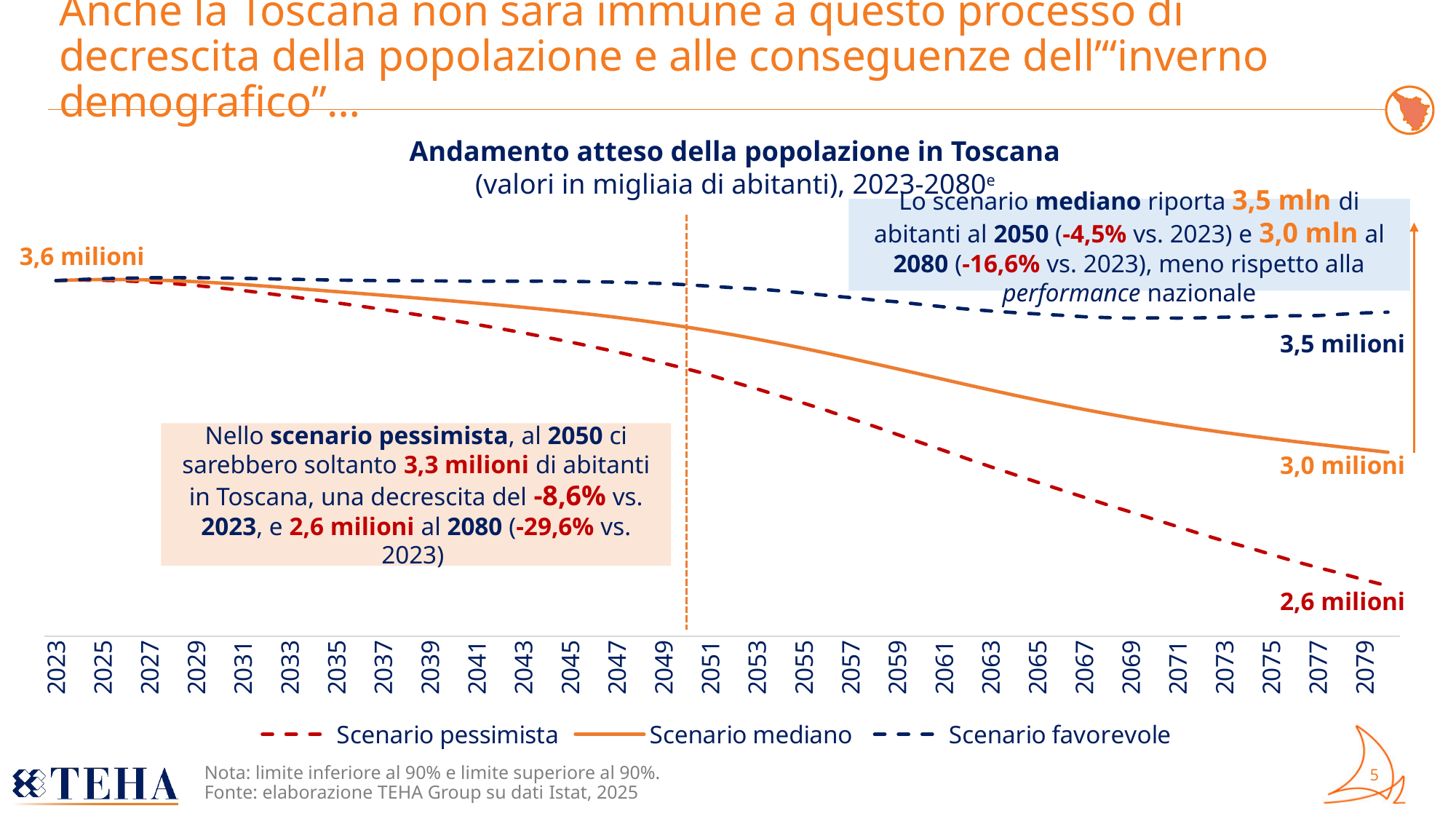
What is the population value labelled at the start of the chart in 2023? 3,6 milioni What value is labelled at the end of the Scenario favorevole line? 3,5 milioni Which scenario has the lowest value at the end of the chart? Scenario pessimista Do the values of the Scenario pessimista line rise or fall from 2023 to 2079? Fall What value is labelled at the end of the Scenario pessimista line? 2,6 milioni What kind of chart is shown on the slide? Line chart What is the title of the chart? Andamento atteso della popolazione in Toscana What value is labelled at the end of the Scenario mediano line? 3,0 milioni Which scenario has the highest value at the end of the chart? Scenario favorevole Which line style is used for the Scenario mediano series? Solid orange line Which is larger at the end of the chart, the Scenario mediano value or the Scenario pessimista value? Scenario mediano How many series does the legend list? 3